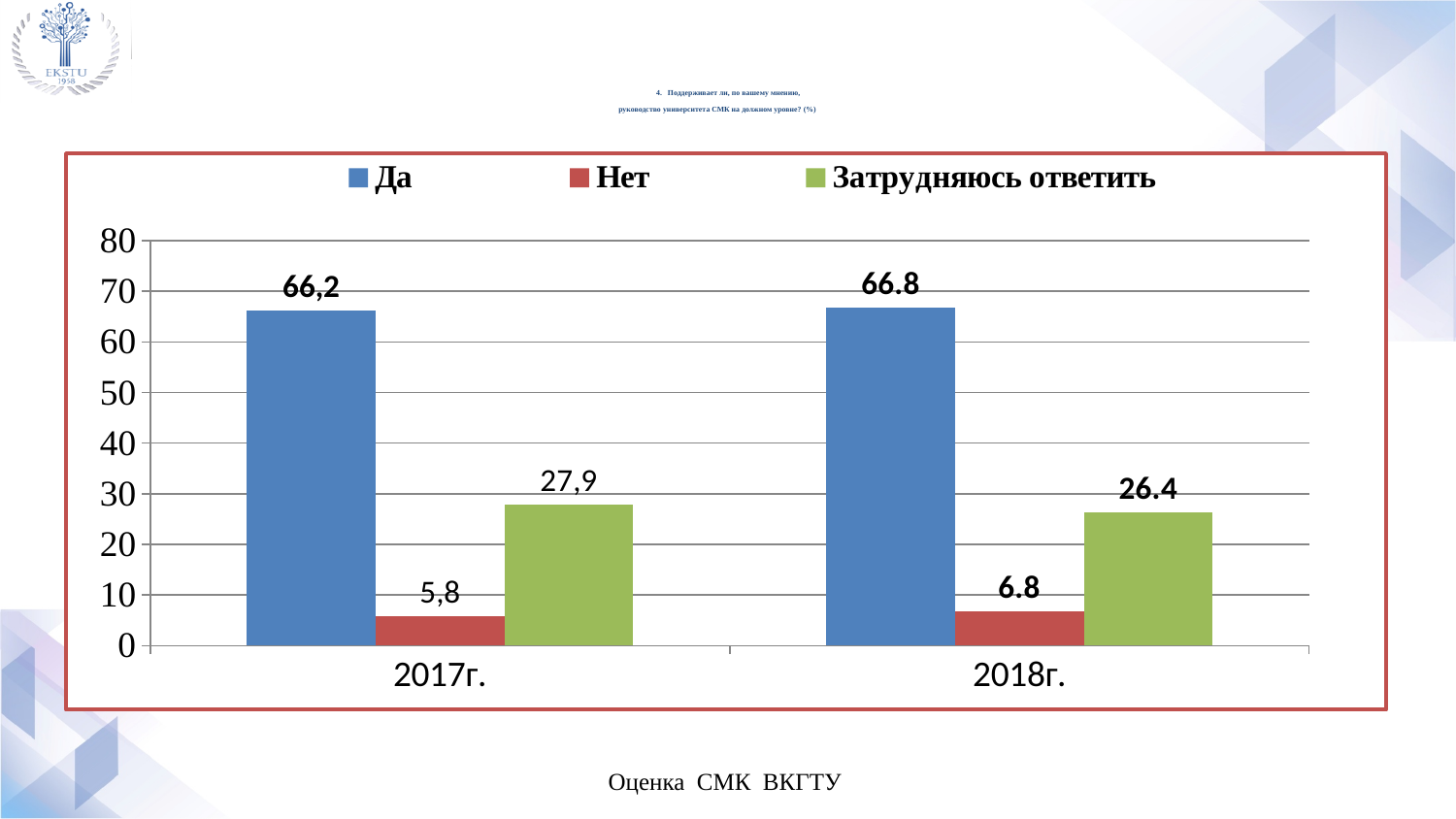
How many year categories are shown on the x axis? 2 What is the difference between "Да" and "Нет" in 2017г.? 60,4 What is the value for "Да" in 2017г.? 66,2 What kind of chart is shown on the slide? Bar chart How many series does the legend list? 3 What is the value for "Нет" in 2018г.? 6.8 Which response has the highest value in 2018г.? Да Which is larger: "Затрудняюсь ответить" in 2017г. or "Затрудняюсь ответить" in 2018г.? 2017г. What is the value for "Затрудняюсь ответить" in 2017г.? 27,9 Which response has the lowest value in 2017г.? Нет What is the difference between "Затрудняюсь ответить" and "Нет" in 2018г.? 19.6 What is the value for "Затрудняюсь ответить" in 2018г.? 26.4